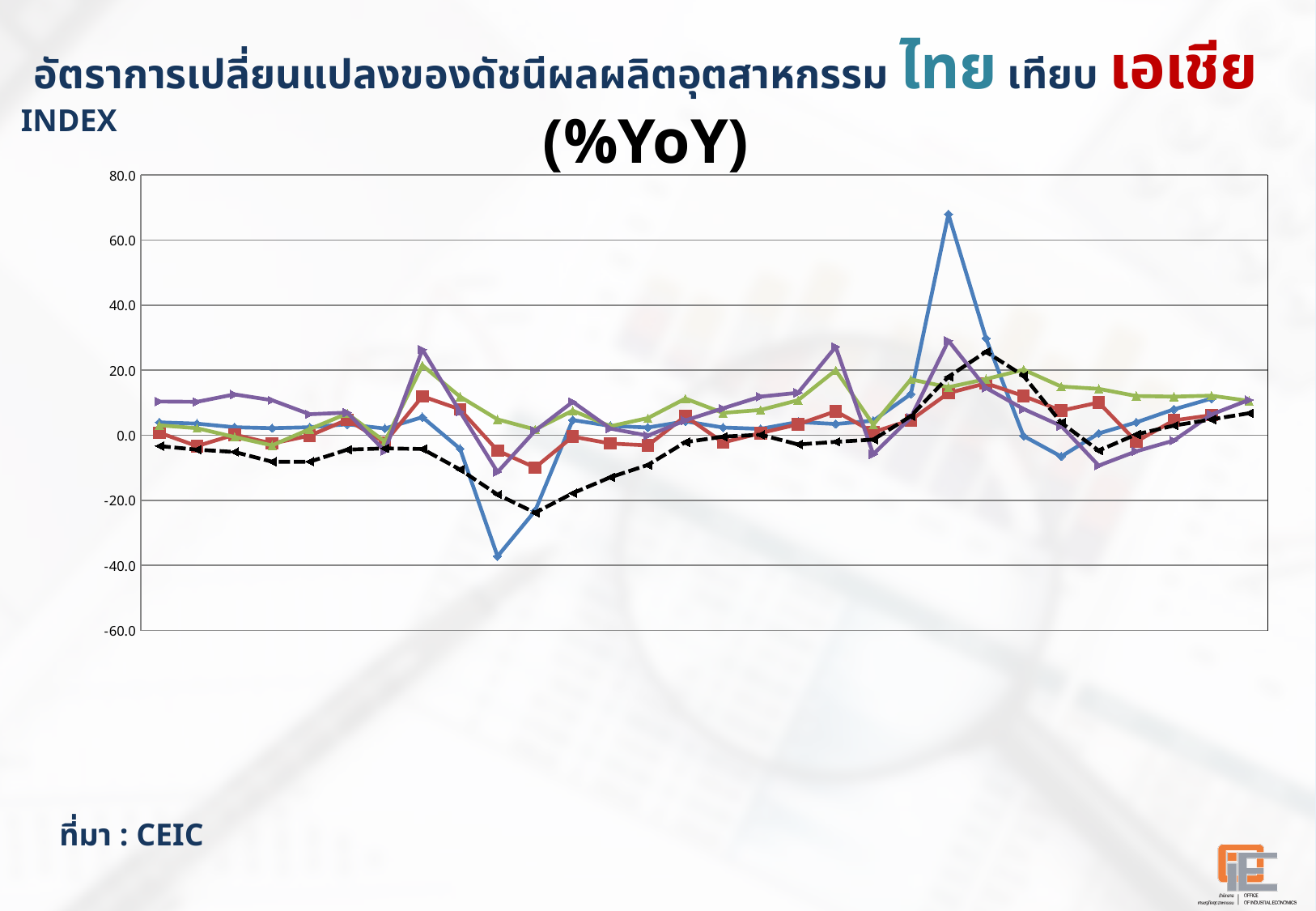
Is the highest value of the purple line greater or less than 40? less Is the lowest value of the black dashed line greater or less than -20? less Which line reaches the lowest point on the chart? the blue line What is the lowest value shown on the vertical axis of the chart? -60.0 Is the lowest value of the blue line greater or less than -20? less What is the highest value shown on the vertical axis of the chart? 80.0 Is the peak of the blue line higher or lower than the peak of the purple line? higher What kind of chart is shown on the slide? line chart How many lines are plotted on the chart? 5 Which line on the chart is drawn dashed? the black line Which line reaches the highest point on the chart? the blue line